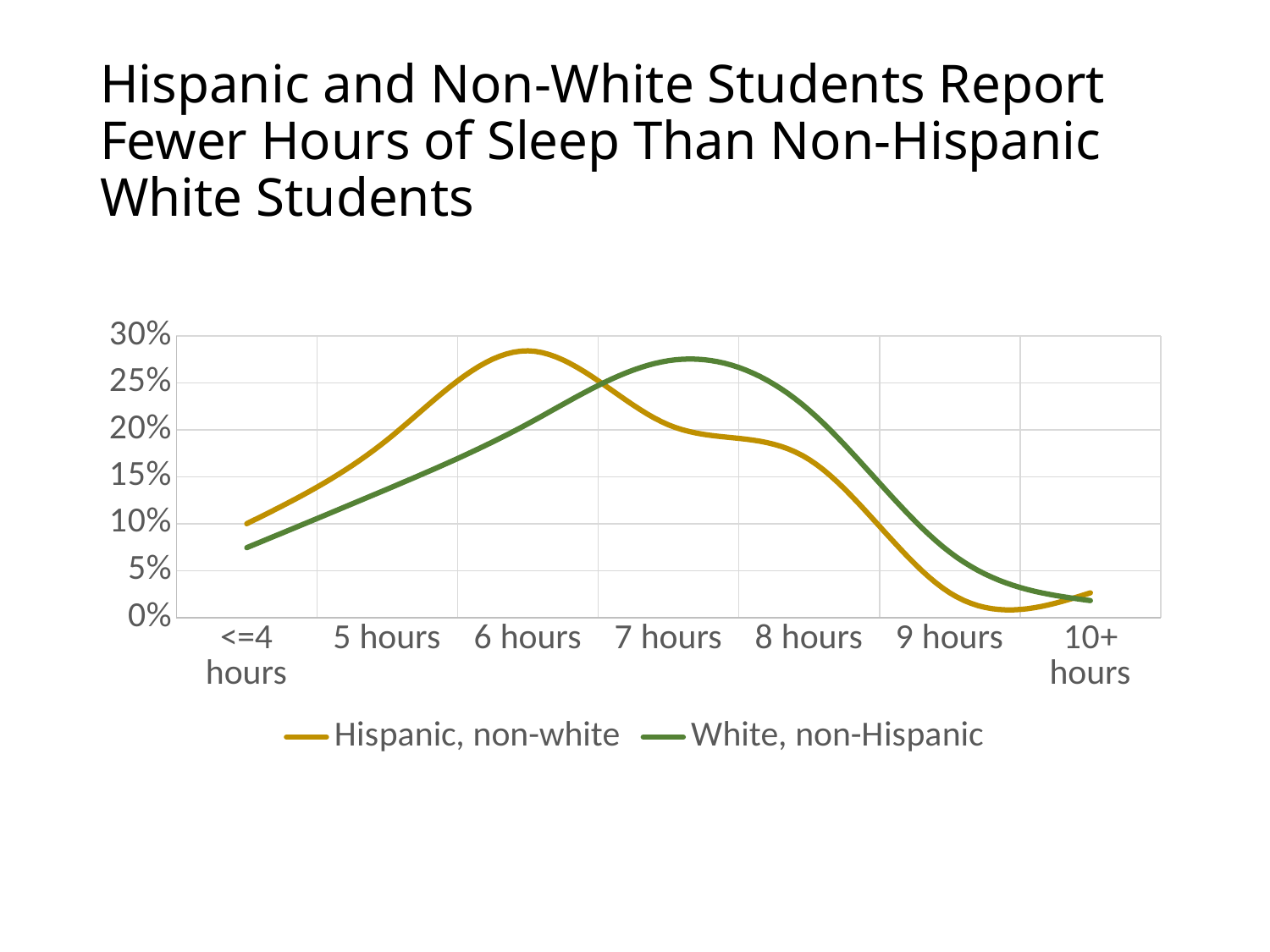
Is the value for White, non-Hispanic at <=4 hours greater or less than 10%? less What kind of chart is shown on the slide? line chart Does the White, non-Hispanic series rise or fall from 7 hours to 10+ hours? fall Is the value for Hispanic, non-white at 6 hours greater or less than 25%? greater At which sleep-hour category does the Hispanic, non-white series reach its highest value? 6 hours At 8 hours, which series has the higher value, Hispanic, non-white or White, non-Hispanic? White, non-Hispanic How many sleep-hour categories are shown on the x axis? 7 At which sleep-hour category is the White, non-Hispanic series lowest? 10+ hours At 6 hours, which series has the higher value, Hispanic, non-white or White, non-Hispanic? Hispanic, non-white How many series does the legend list? 2 At which sleep-hour category does the White, non-Hispanic series reach its highest value? 7 hours What colour is the line for the Hispanic, non-white series? gold